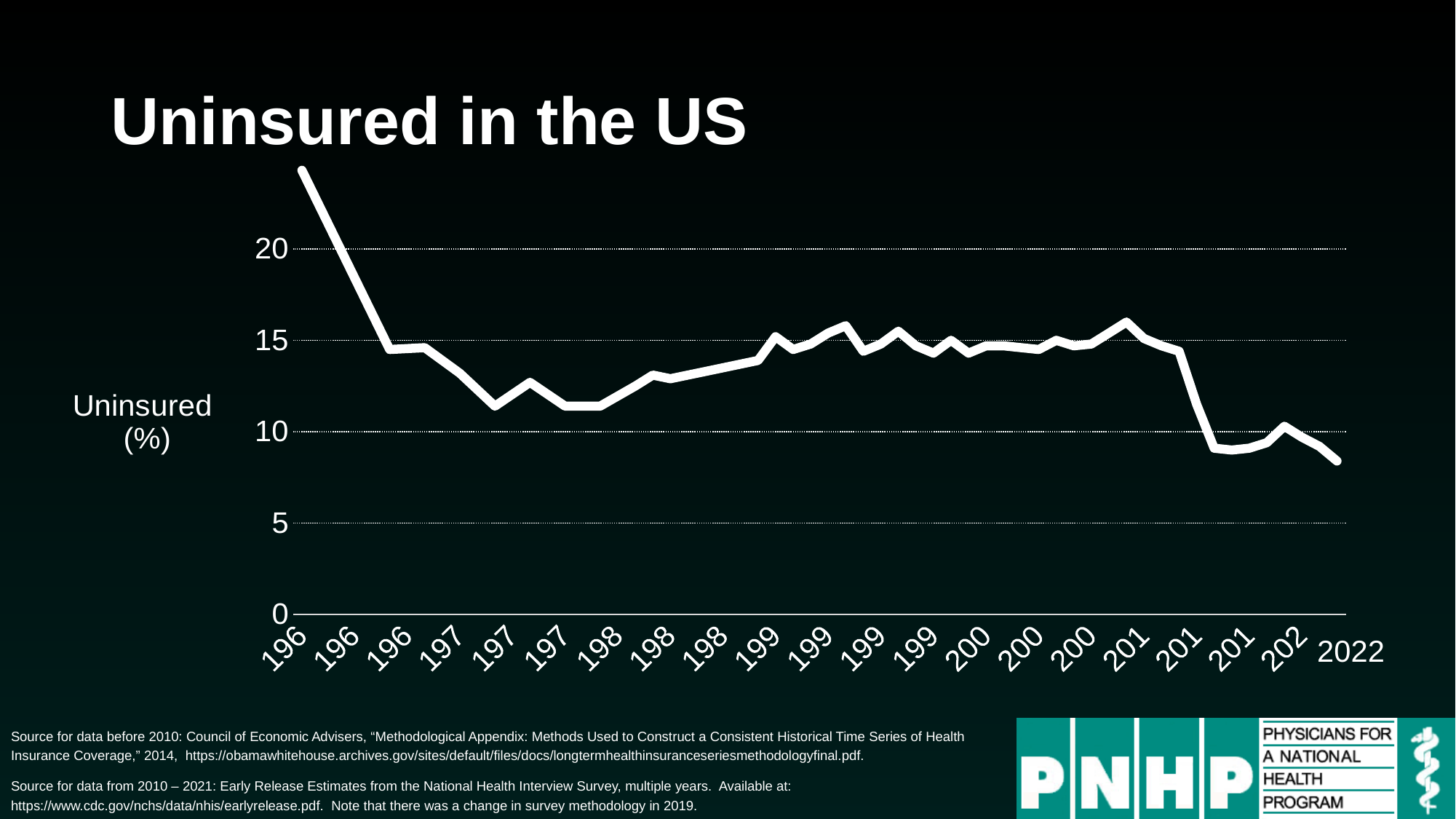
What is the title of the chart? Uninsured in the US Is the value for 2022 larger or smaller than the value at the earliest point of the line? smaller Is the value for 2022 greater or less than 5? greater Overall, does the uninsured rate rise or fall from the start of the series to 2022? fall What is the highest value shown on the vertical axis? 20 Which year on the x axis has the lowest uninsured rate? 2022 What kind of chart is shown on the slide? line chart Is the value at the leftmost (earliest) point of the line greater or less than 20? greater Is the highest value of the line at the start or at the end of the series? start What is the label on the vertical axis of the chart? Uninsured (%) Is the value for 2022 greater or less than 10? less